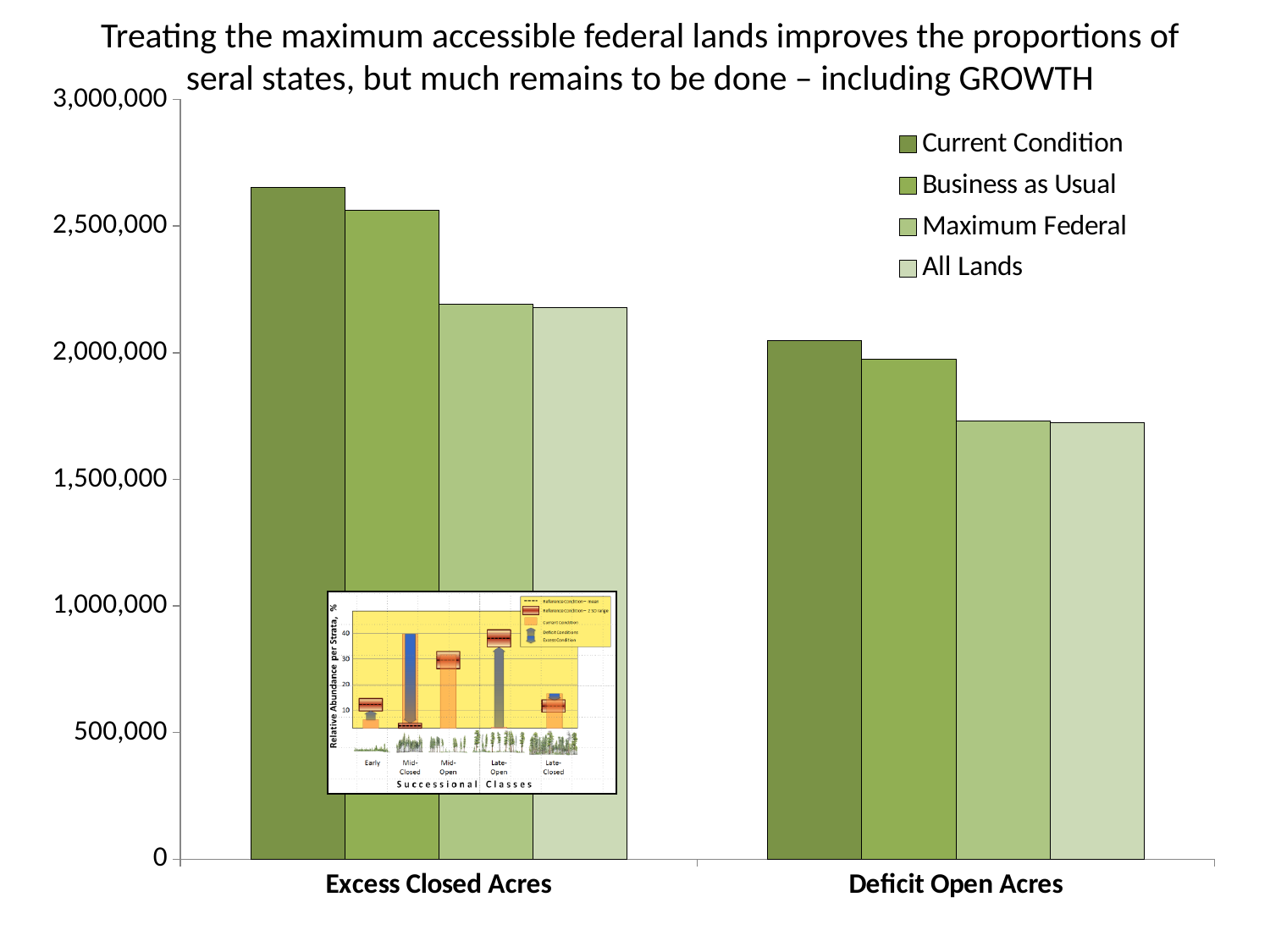
For the Current Condition series, which category has the larger value, Excess Closed Acres or Deficit Open Acres? Excess Closed Acres Is the Maximum Federal value for Deficit Open Acres greater or less than 2,000,000? less Is the Current Condition value for Excess Closed Acres greater or less than 2,500,000? greater What kind of chart is shown on the slide? bar chart How many series does the legend list? 4 What are the names of the two categories on the x axis? Excess Closed Acres and Deficit Open Acres Is the Current Condition value for Deficit Open Acres greater or less than 2,000,000? greater For Excess Closed Acres, which is larger, Business as Usual or Maximum Federal? Business as Usual Which series has the highest value for Excess Closed Acres? Current Condition Which series has the highest value for Deficit Open Acres? Current Condition How many categories are shown on the x axis? 2